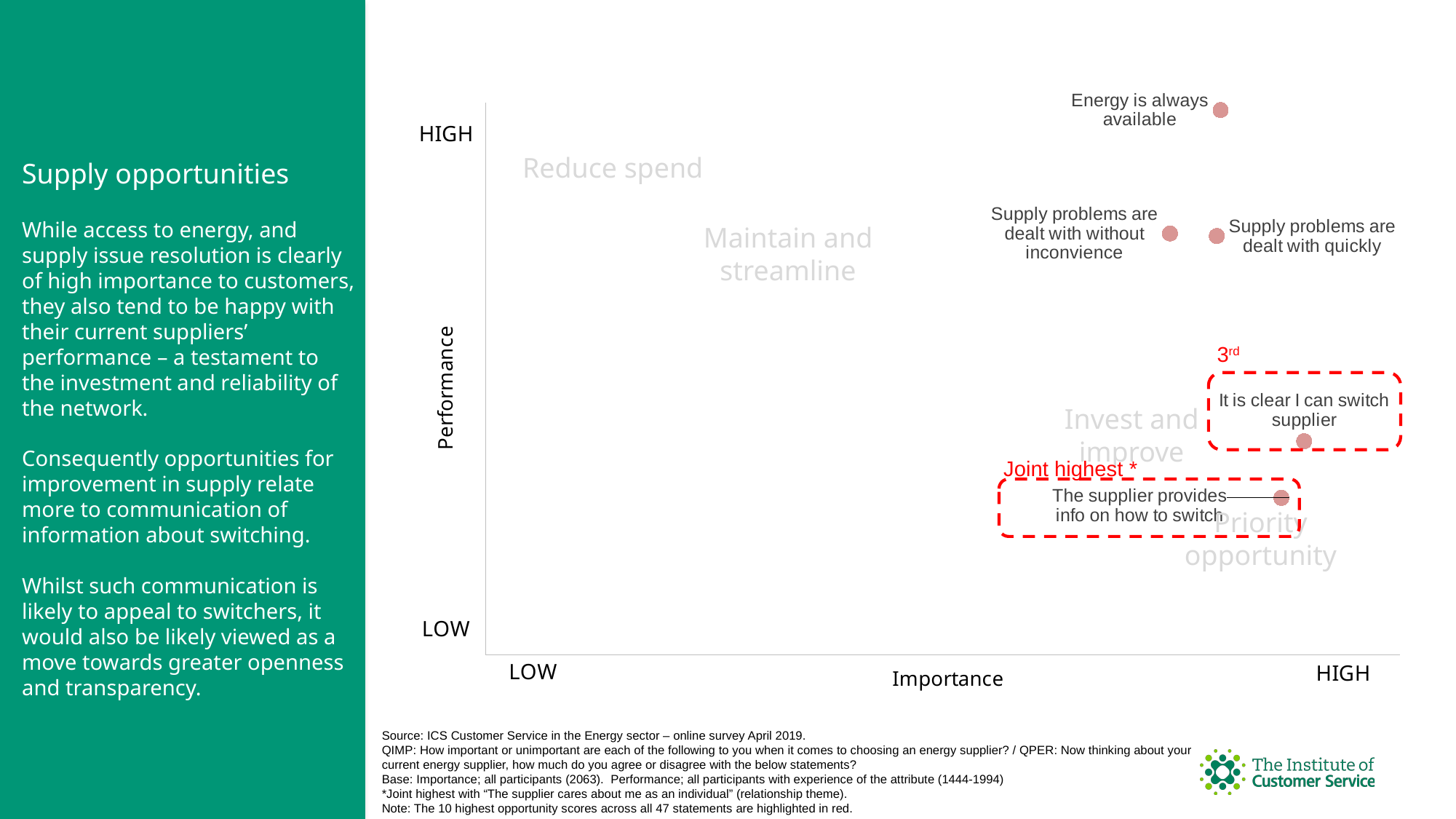
Which has higher performance: 'It is clear I can switch supplier' or 'The supplier provides info on how to switch'? It is clear I can switch supplier Which has higher importance: 'Supply problems are dealt with quickly' or 'Supply problems are dealt with without inconvenience'? Supply problems are dealt with quickly What is the label of the vertical axis of the chart? Performance What kind of chart is shown on the slide? Scatter chart Which statement is labelled 'Joint highest *' on the chart? The supplier provides info on how to switch Which has higher performance: 'Energy is always available' or 'It is clear I can switch supplier'? Energy is always available Which statement has the lowest performance on the chart? The supplier provides info on how to switch Which statement is labelled '3rd' on the chart? It is clear I can switch supplier How many data points are plotted on the chart? 5 Which statement has the highest performance on the chart? Energy is always available What is the label of the horizontal axis of the chart? Importance Which statement is plotted furthest to the right, i.e. has the highest importance? It is clear I can switch supplier